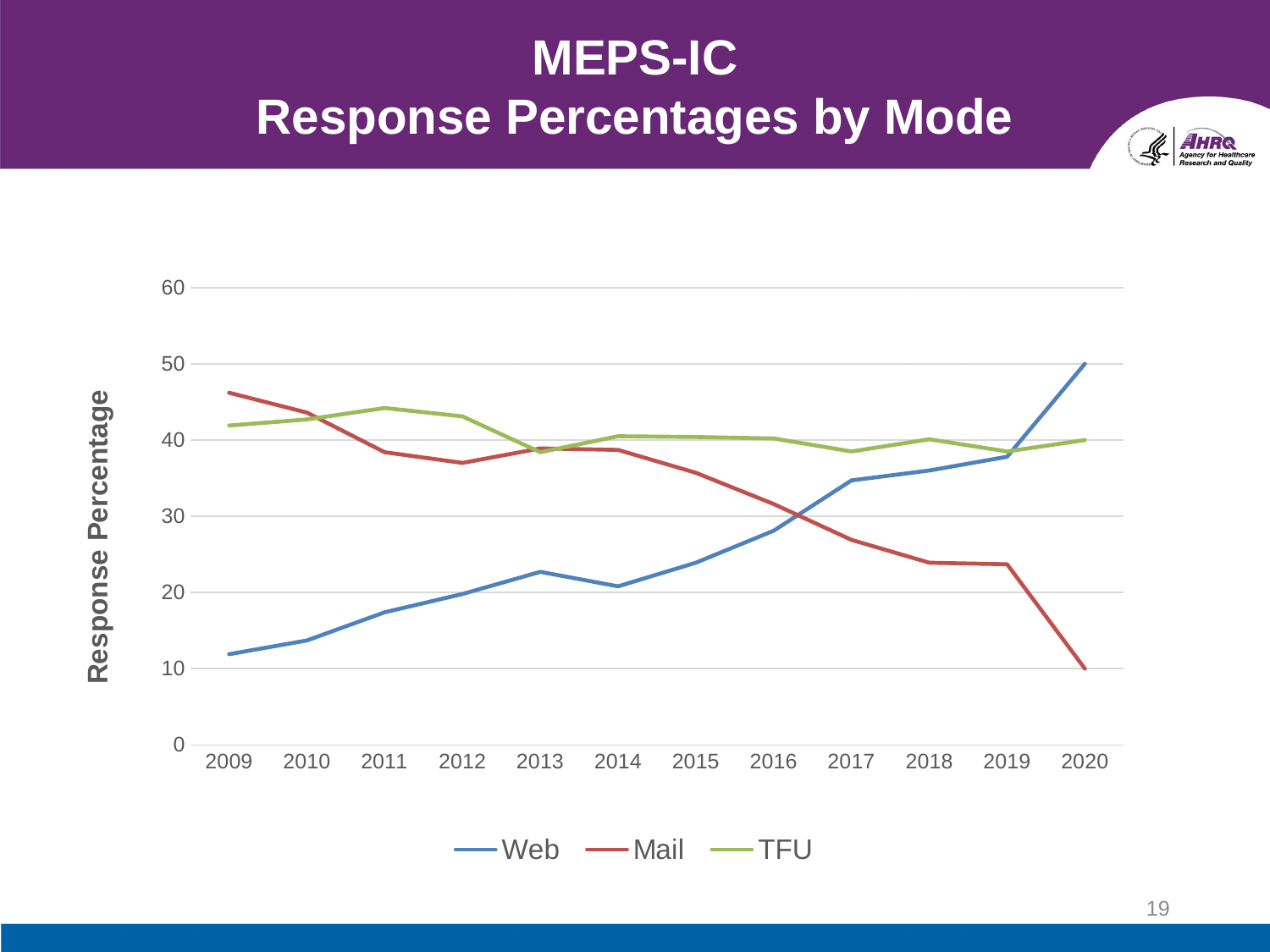
Is the Web response percentage in 2009 greater or less than 20? less Which mode had the highest response percentage in 2020? Web Which mode had the lowest response percentage in 2020? Mail Does the Web response percentage rise or fall from 2009 to 2020? rise How many years are shown on the x axis? 12 Does the Mail response percentage rise or fall from 2009 to 2020? fall What kind of chart is shown on the slide? line chart In 2014, which is larger, the Web or the TFU response percentage? TFU Is the Mail response percentage in 2018 greater or less than 30? less How many series does the legend list? 3 Is the Mail response percentage in 2009 greater or less than 40? greater Which mode had the highest response percentage in 2009? Mail